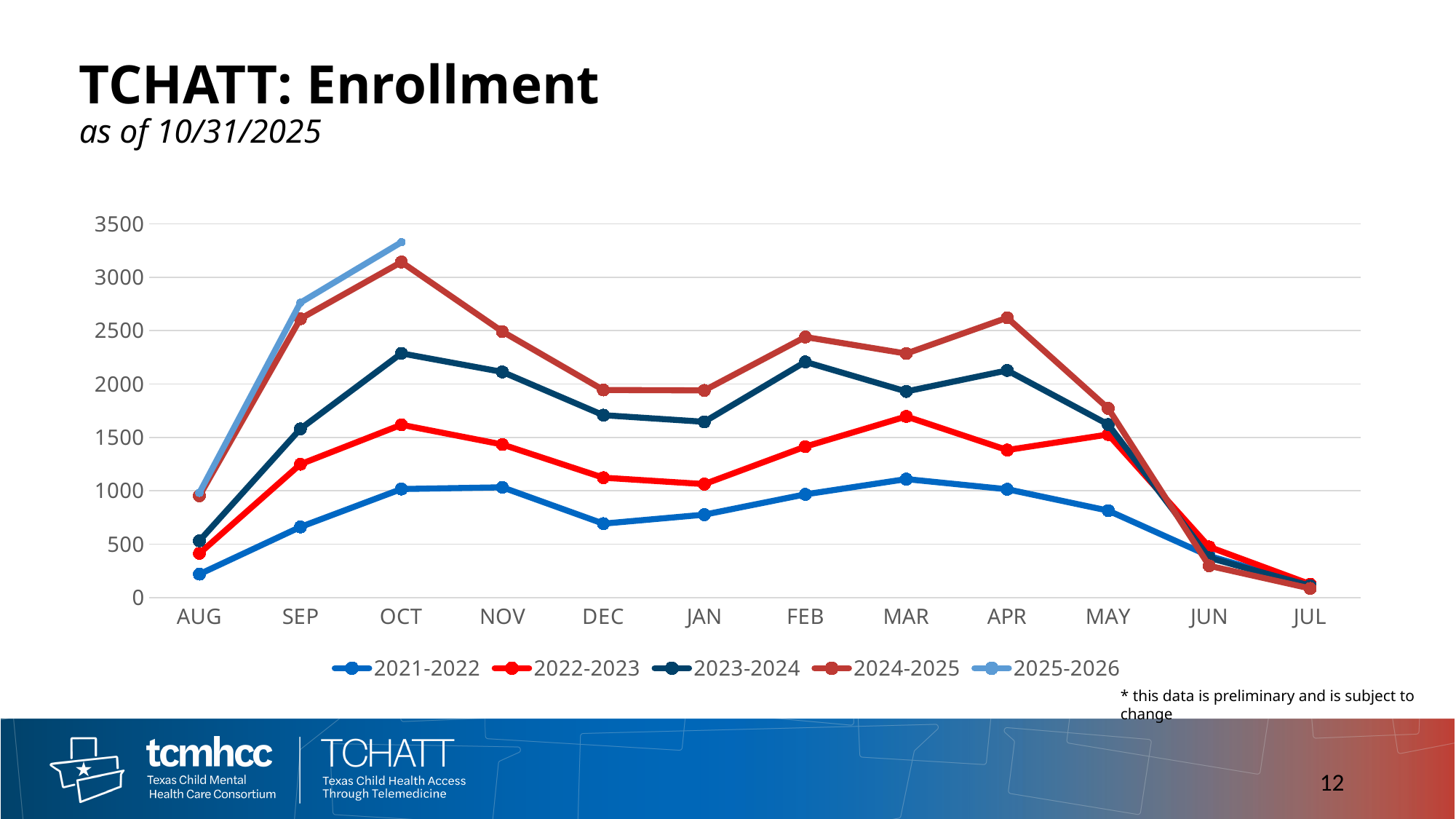
Which series in the legend has data plotted only for AUG, SEP and OCT? 2025-2026 Is the value for 2021-2022 in DEC greater or less than 1000? less Is the value for 2023-2024 in OCT greater or less than 2000? greater How many months are shown along the x axis? 12 Is the value for 2021-2022 in AUG greater or less than 500? less Does the 2024-2025 series rise or fall from OCT to DEC? fall In OCT, which series has the larger value, 2024-2025 or 2023-2024? 2024-2025 How many series does the legend list? 5 In which month does the 2021-2022 series reach its highest value? MAR What kind of chart is shown on the slide? line chart In which month does the 2024-2025 series reach its highest value? OCT